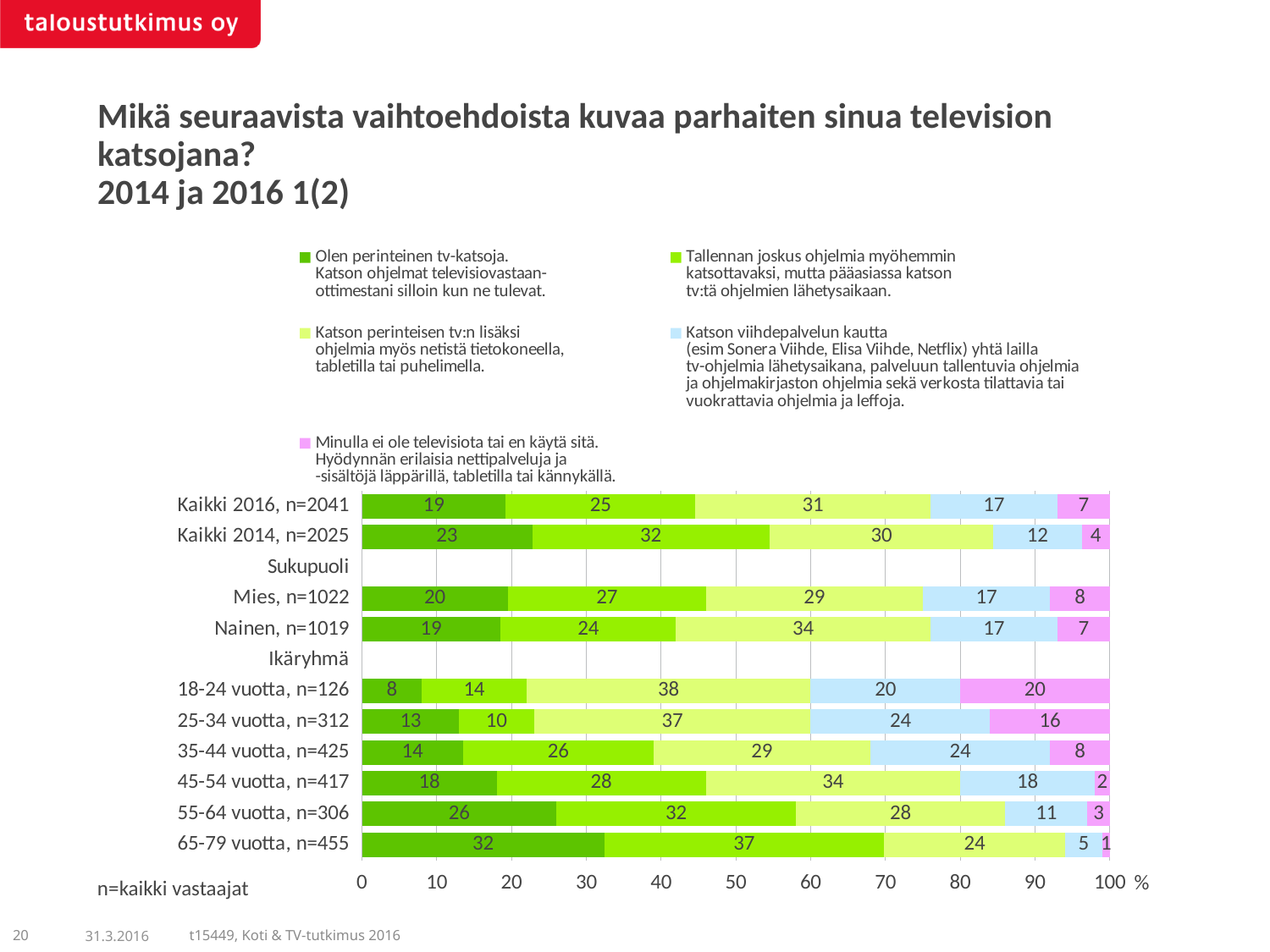
What is the value for 'Katson viihdepalvelun kautta' in the '55-64 vuotta, n=306' group? 11 What kind of chart is shown on the slide? Stacked bar chart How many respondent groups have bars plotted in the chart? 10 How many series does the legend list? 5 Which has the larger value for 'Katson perinteisen tv:n lisäksi ohjelmia myös netistä', 'Mies, n=1022' or 'Nainen, n=1019'? Nainen, n=1019 What unit is shown at the end of the horizontal axis? % Which respondent group has the highest value for 'Olen perinteinen tv-katsoja'? 65-79 vuotta, n=455 Which respondent group has the highest value for 'Minulla ei ole televisiota tai en käytä sitä'? 18-24 vuotta, n=126 By how many percentage points did 'Tallennan joskus ohjelmia myöhemmin katsottavaksi' fall from 'Kaikki 2014' to 'Kaikki 2016'? 7 Which respondent group has the lowest value for 'Olen perinteinen tv-katsoja'? 18-24 vuotta, n=126 What percentage of the 'Kaikki 2016, n=2041' group chose 'Olen perinteinen tv-katsoja'? 19 What is the value for 'Minulla ei ole televisiota tai en käytä sitä' in the '18-24 vuotta, n=126' group? 20